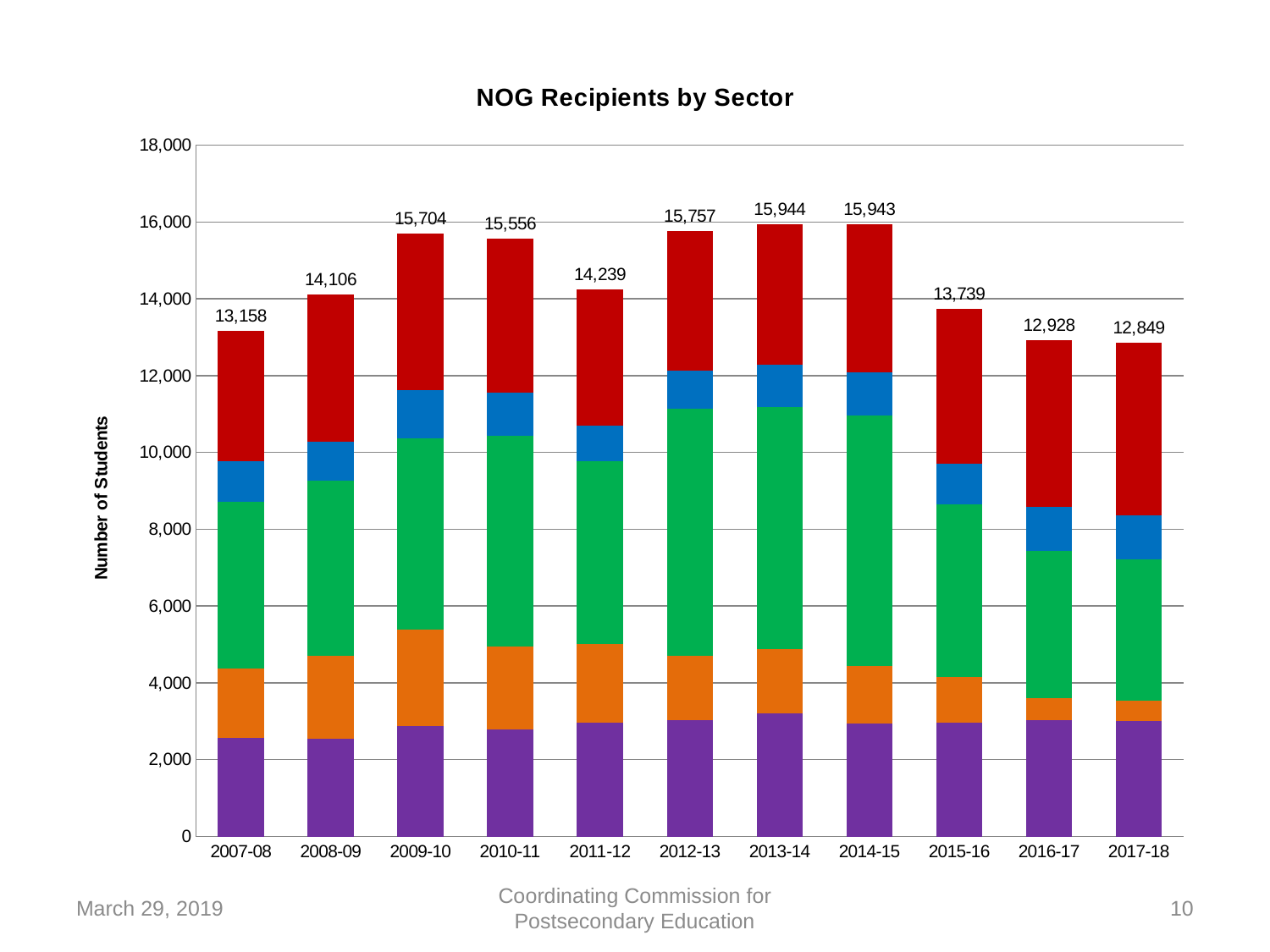
What is the total number of NOG recipients shown for 2007-08? 13,158 What kind of chart is shown on the slide? Stacked bar chart What is the total value labeled above the 2013-14 bar? 15,944 What is the difference between the totals for 2009-10 and 2008-09? 1,598 Which year has the lowest total number of NOG recipients? 2017-18 How many academic years are shown on the x axis? 11 Do the total values rise or fall from 2014-15 to 2017-18? Fall Which year has a larger total, 2010-11 or 2015-16? 2010-11 What is the total number of NOG recipients shown for 2017-18? 12,849 What is the difference between the totals for 2013-14 and 2007-08? 2,786 What is the total value labeled for 2011-12? 14,239 What is the title of the chart? NOG Recipients by Sector